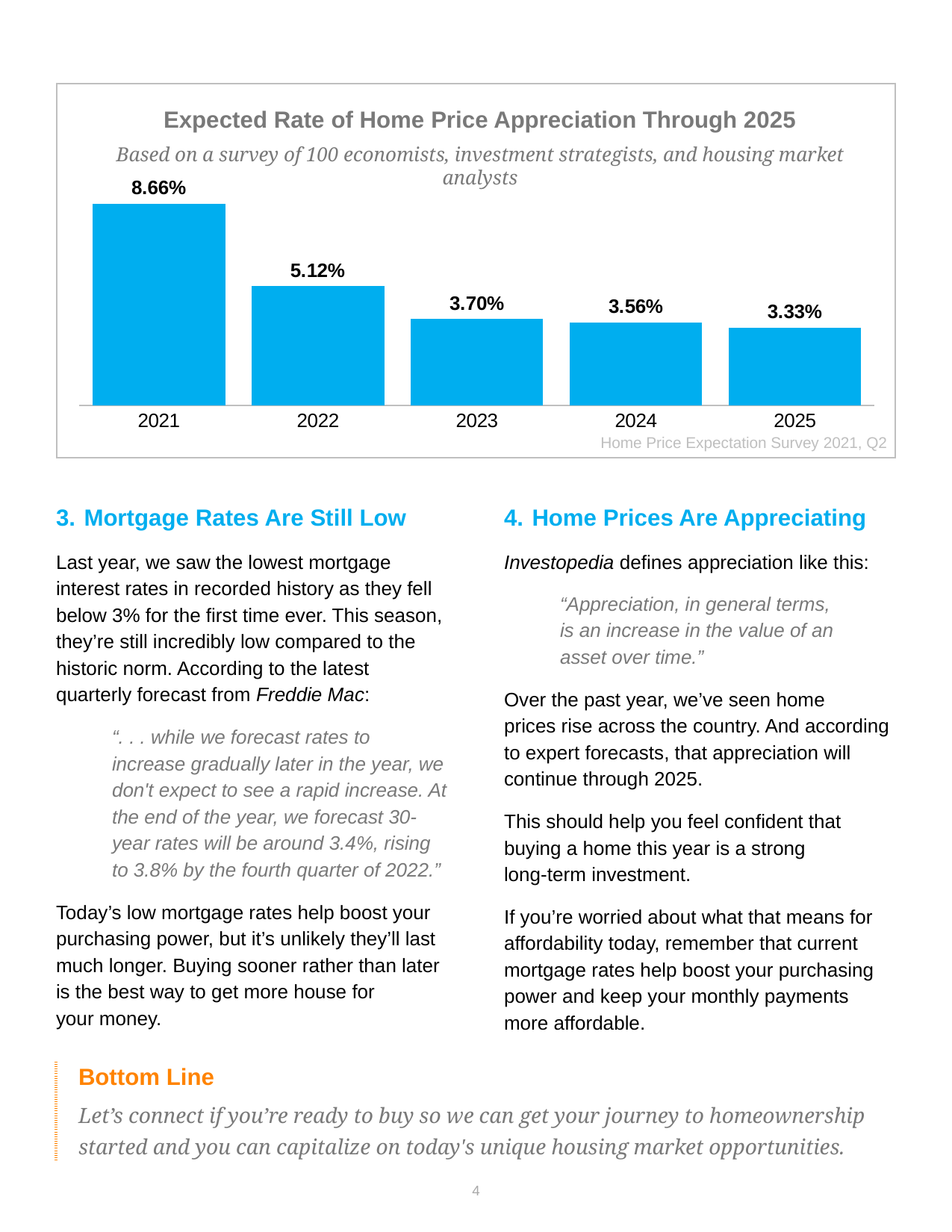
What is the difference between the expected appreciation rates for 2024 and 2025? 0.23% Which year has a higher expected appreciation rate, 2022 or 2023? 2022 What is the title of the chart? Expected Rate of Home Price Appreciation Through 2025 What is the expected rate of home price appreciation for 2021? 8.66% Which year has the lowest expected rate of home price appreciation? 2025 What is the expected rate of home price appreciation for 2023? 3.70% Which year has the highest expected rate of home price appreciation? 2021 How many years are shown in the chart? 5 What kind of chart is shown on the slide? Bar chart What is the difference between the expected appreciation rates for 2021 and 2022? 3.54% Do the expected appreciation rates rise or fall from 2021 to 2025? Fall What is the expected rate of home price appreciation for 2025? 3.33%